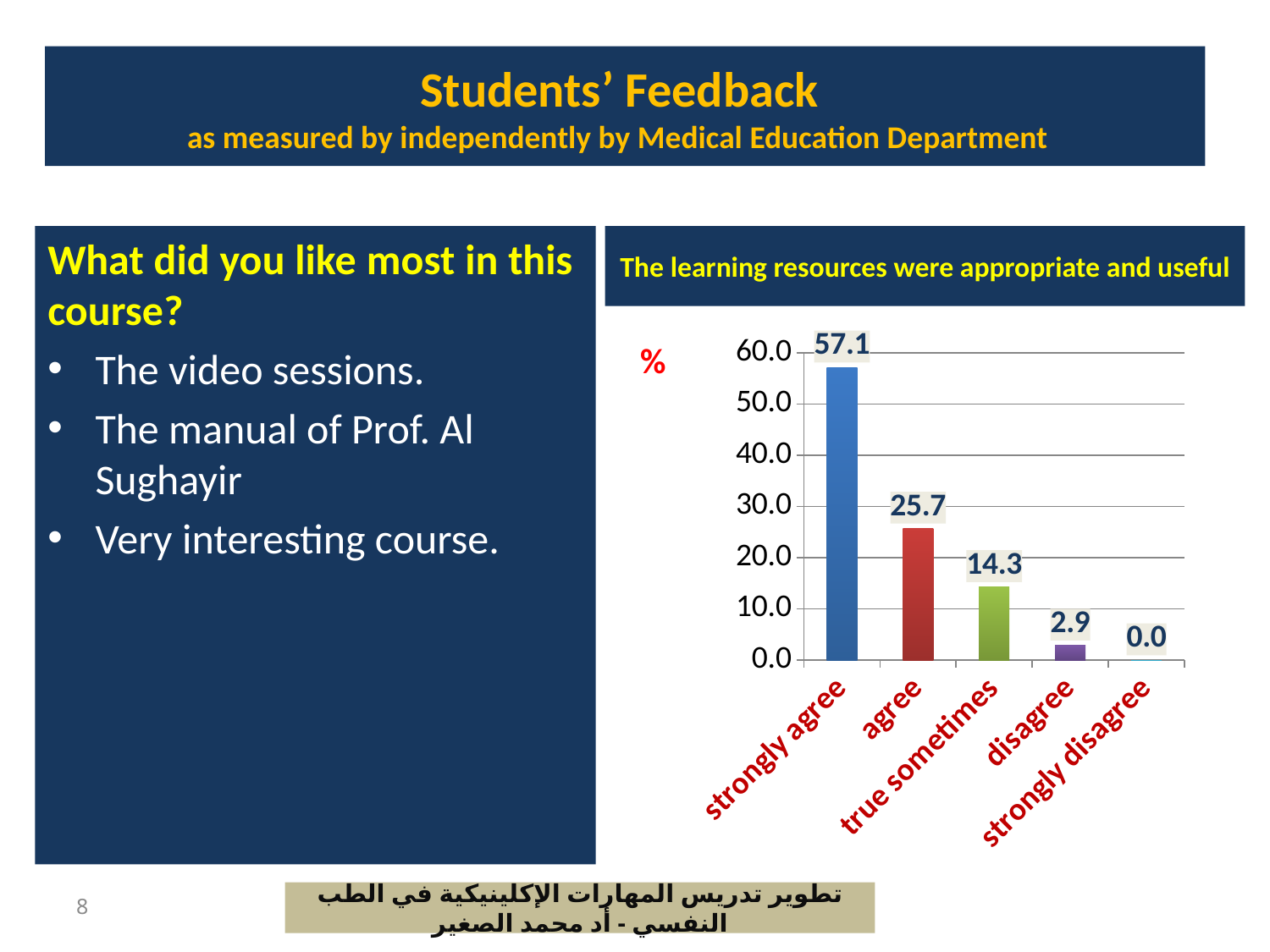
What is the value for 'strongly agree'? 57.1 What is the value for 'true sometimes'? 14.3 What is the difference between the values for 'strongly agree' and 'agree'? 31.4 Which category has the lowest value? strongly disagree How many categories are shown on the x axis? 5 Which category has the highest value? strongly agree What kind of chart is shown? bar chart What is the value for 'agree'? 25.7 What is the value for 'strongly disagree'? 0.0 What is the value for 'disagree'? 2.9 What is the title of the chart? The learning resources were appropriate and useful Which is larger, the value for 'true sometimes' or the value for 'disagree'? true sometimes